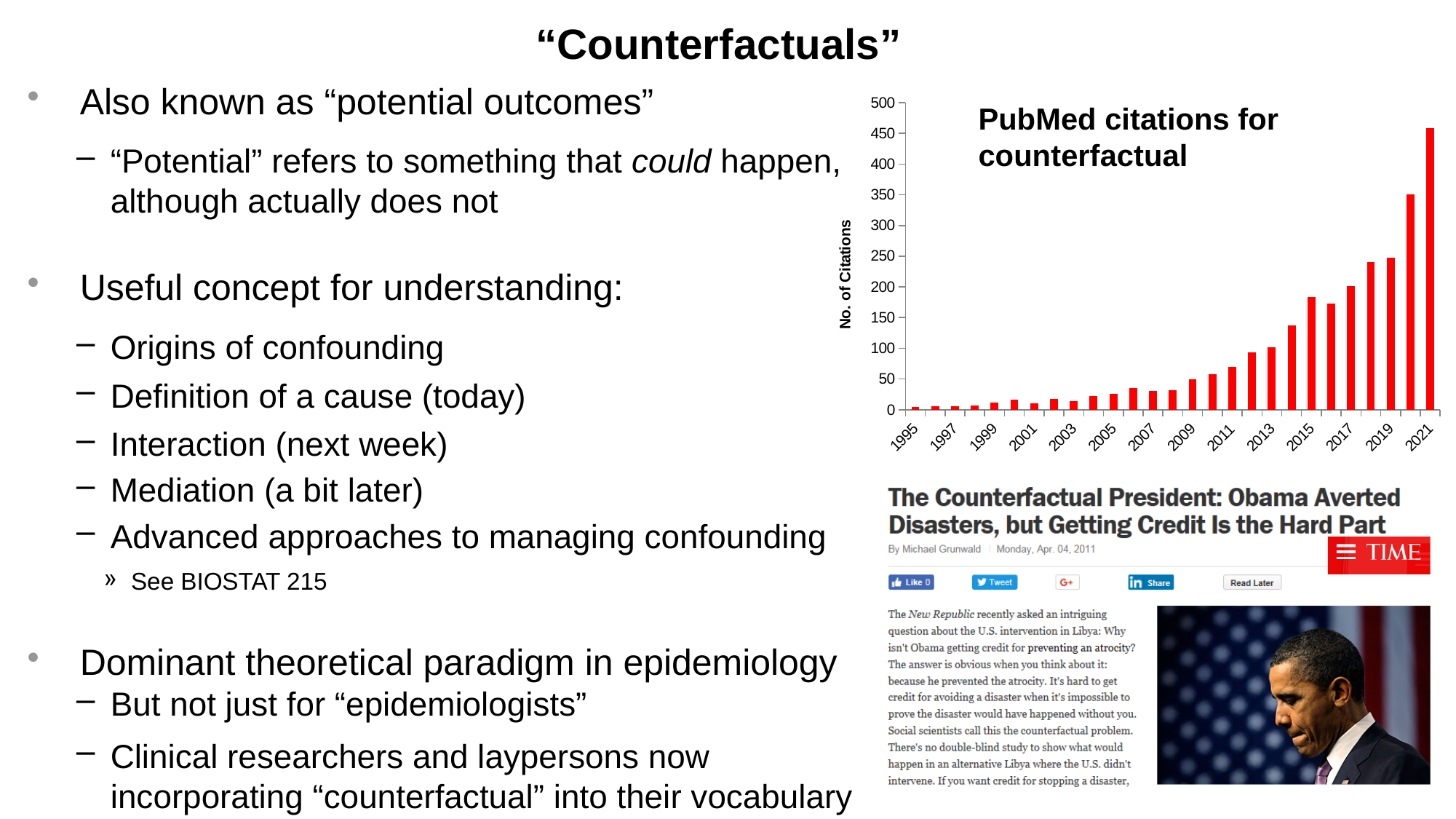
Is the number of citations in 2021 greater or less than 400? greater What is the label on the vertical axis of the PubMed citations chart? No. of Citations Is the number of citations in 2016 greater or less than 150? greater Is the number of citations in 2011 greater or less than 50? greater Overall, do the PubMed citations for counterfactual rise or fall from 1995 to 2021? rise What colour are the bars in the PubMed citations chart? red Which year has more PubMed citations for counterfactual, 2020 or 2021? 2021 Which year has the highest number of PubMed citations for counterfactual? 2021 What kind of chart is used to show PubMed citations for counterfactual? bar chart